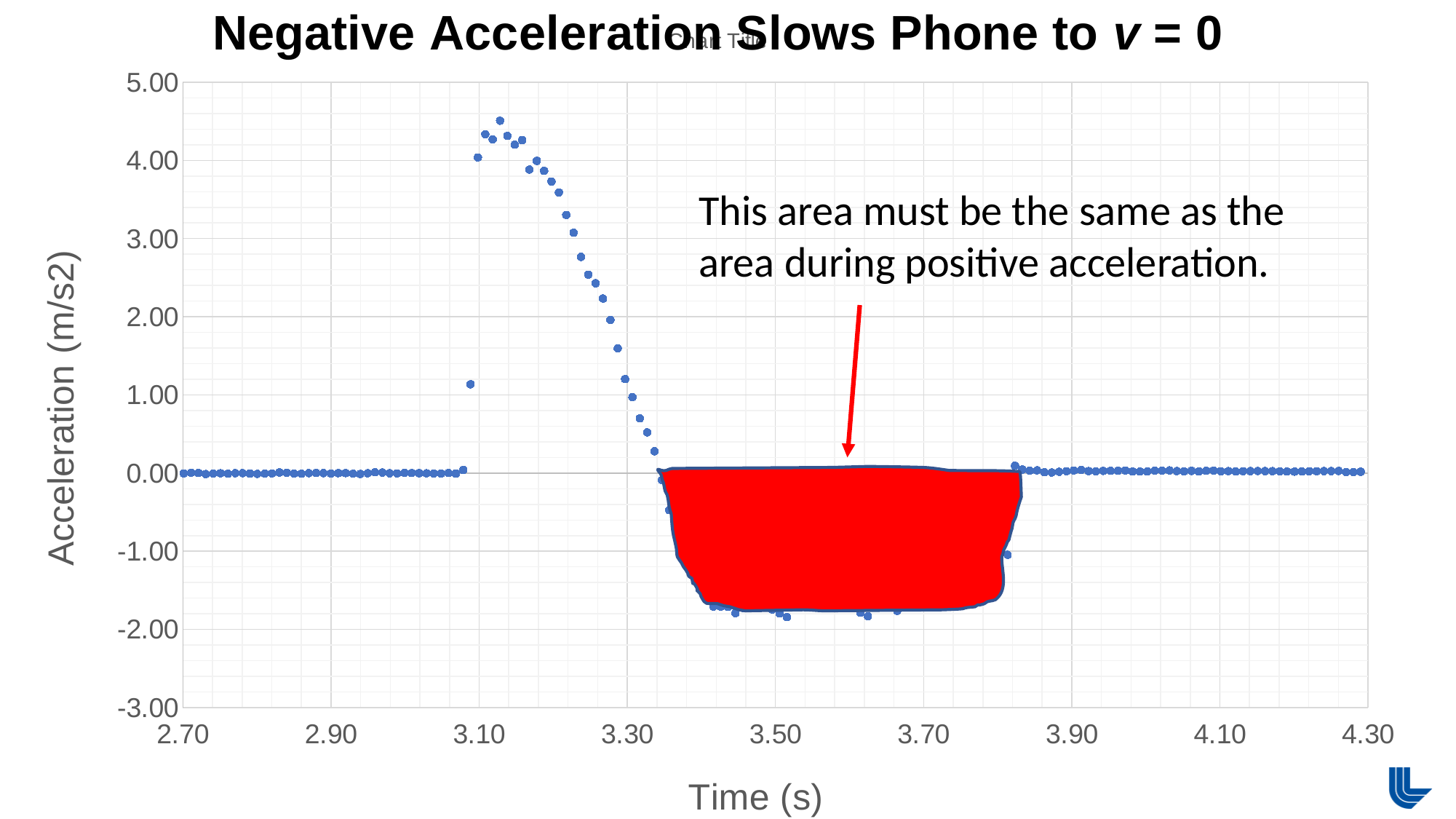
Is the acceleration at time 2.90 s greater or less than 1.00? less Is the lowest acceleration value greater or less than -1.00? less Between time 3.10 s and 3.30 s, do the acceleration values rise or fall? fall Which is larger, the acceleration at time 3.20 s or at time 3.60 s? 3.20 s Is the acceleration at time 3.50 s greater or less than -1.00? less What is the label on the y axis? Acceleration (m/s2) What is the label on the x axis? Time (s) What kind of chart is shown on the slide? scatter chart